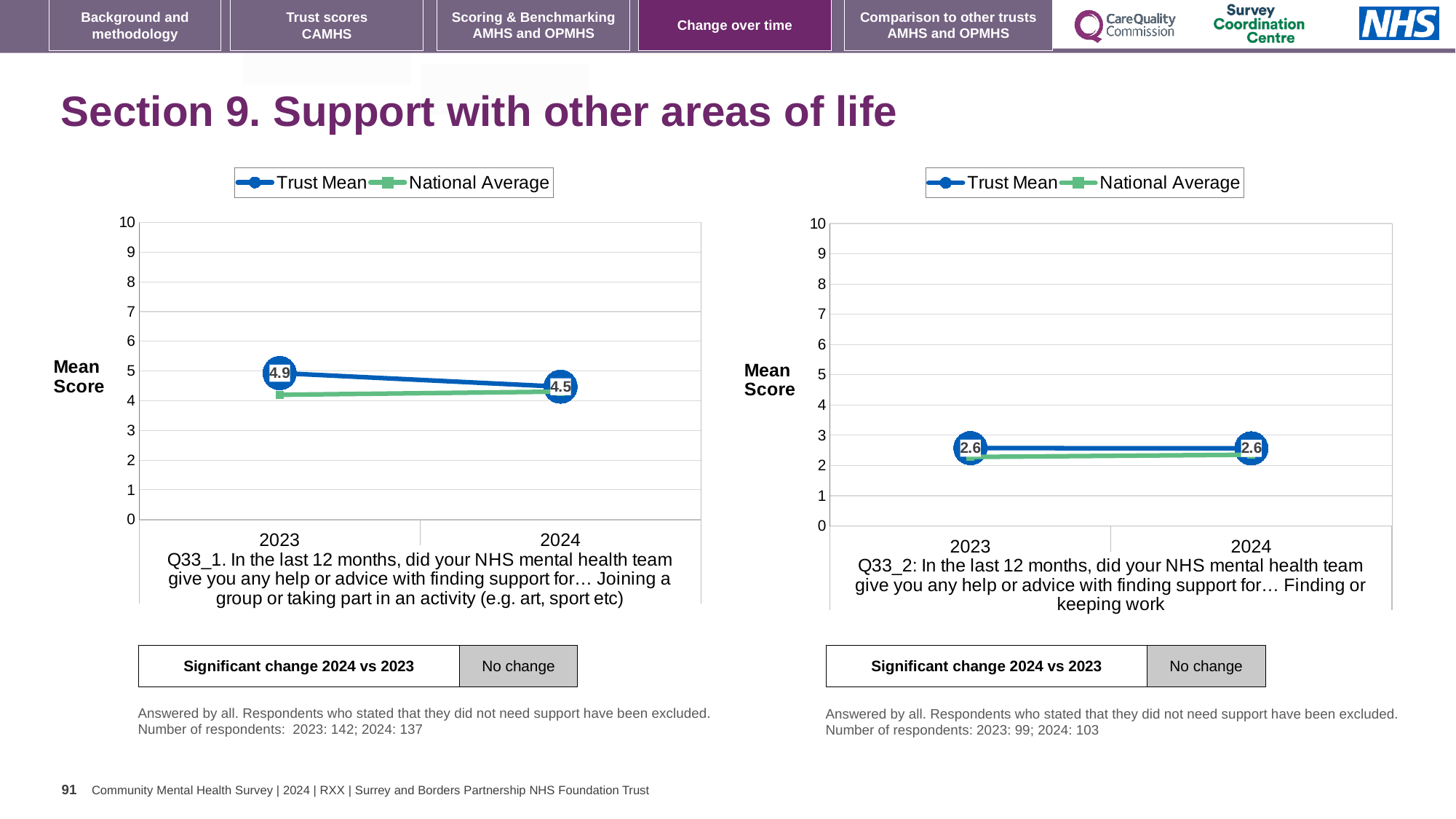
In the right chart (Q33_2), is the National Average value for 2024 greater or less than 3? less In the left chart (Q33_1), is the National Average value for 2023 greater or less than 5? less What kind of chart is the left chart (Q33_1)? line chart In the right chart (Q33_2), what is the Trust Mean score for 2024? 2.6 In the left chart (Q33_1), what is the Trust Mean score for 2023? 4.9 In the left chart (Q33_1), what is the Trust Mean score for 2024? 4.5 How many series does the legend of the right chart (Q33_2) list? 2 In the left chart (Q33_1), which series has the higher value in 2023, Trust Mean or National Average? Trust Mean In the left chart (Q33_1), does the Trust Mean rise or fall from 2023 to 2024? fall In the left chart (Q33_1), by how much did the Trust Mean change from 2023 to 2024? 0.4 In the right chart (Q33_2), does the Trust Mean rise, fall or stay the same from 2023 to 2024? stay the same How many years are shown on the x axis of the left chart (Q33_1)? 2